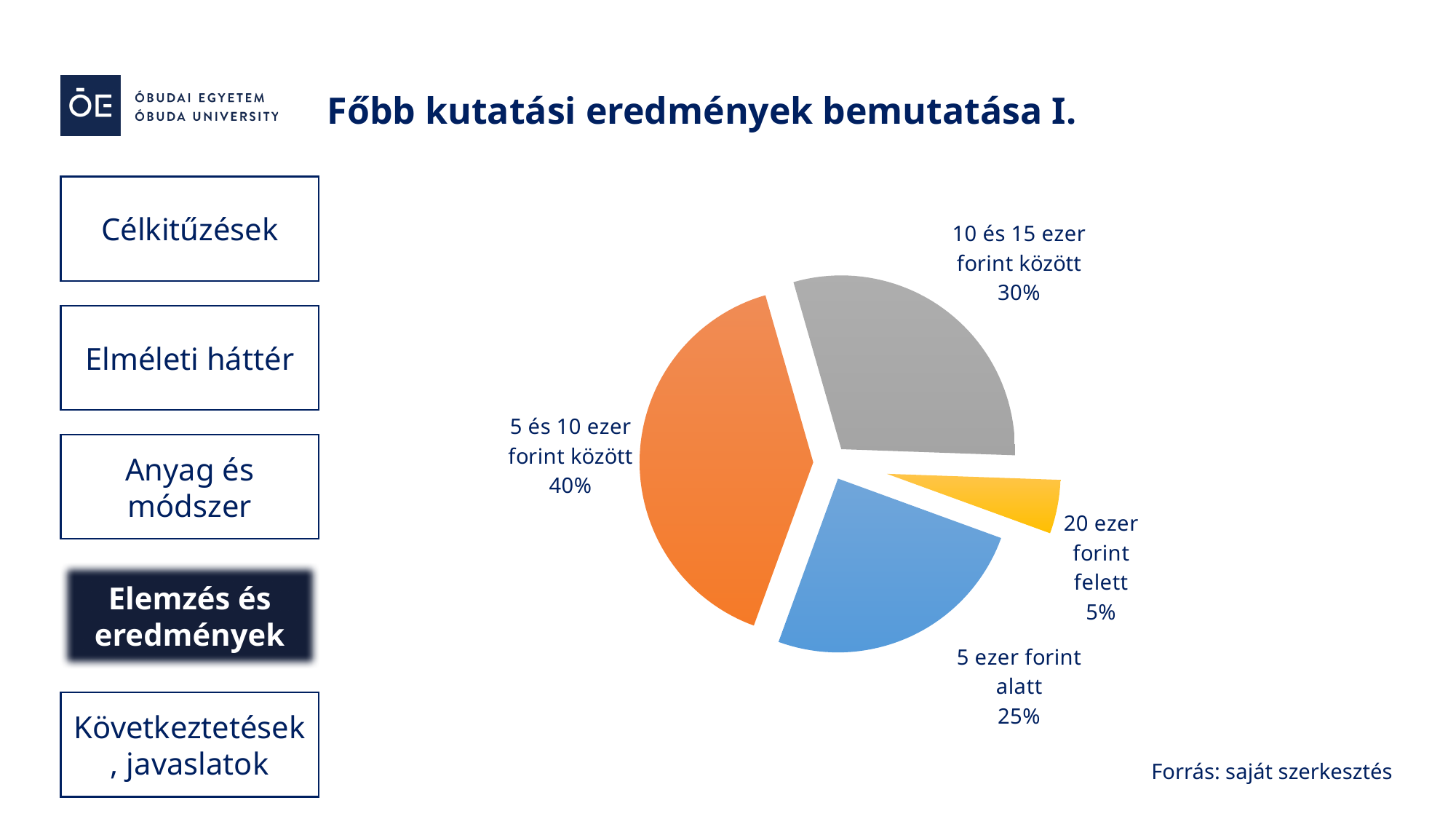
Which is larger: the "10 és 15 ezer forint között" slice or the "5 ezer forint alatt" slice? 10 és 15 ezer forint között What share of the pie does the "10 és 15 ezer forint között" slice represent? 30% What share of the pie does the "20 ezer forint felett" slice represent? 5% What share of the pie does the "5 ezer forint alatt" slice represent? 25% Which category has the smallest share of the pie? 20 ezer forint felett What colour is the "5 ezer forint alatt" slice? blue What is the combined share of the "10 és 15 ezer forint között" and "20 ezer forint felett" slices? 35% What is the difference in percentage points between the "5 és 10 ezer forint között" slice and the "5 ezer forint alatt" slice? 15% How many slices does the pie chart have? 4 What kind of chart is shown on the slide? pie chart Which category has the largest share of the pie? 5 és 10 ezer forint között